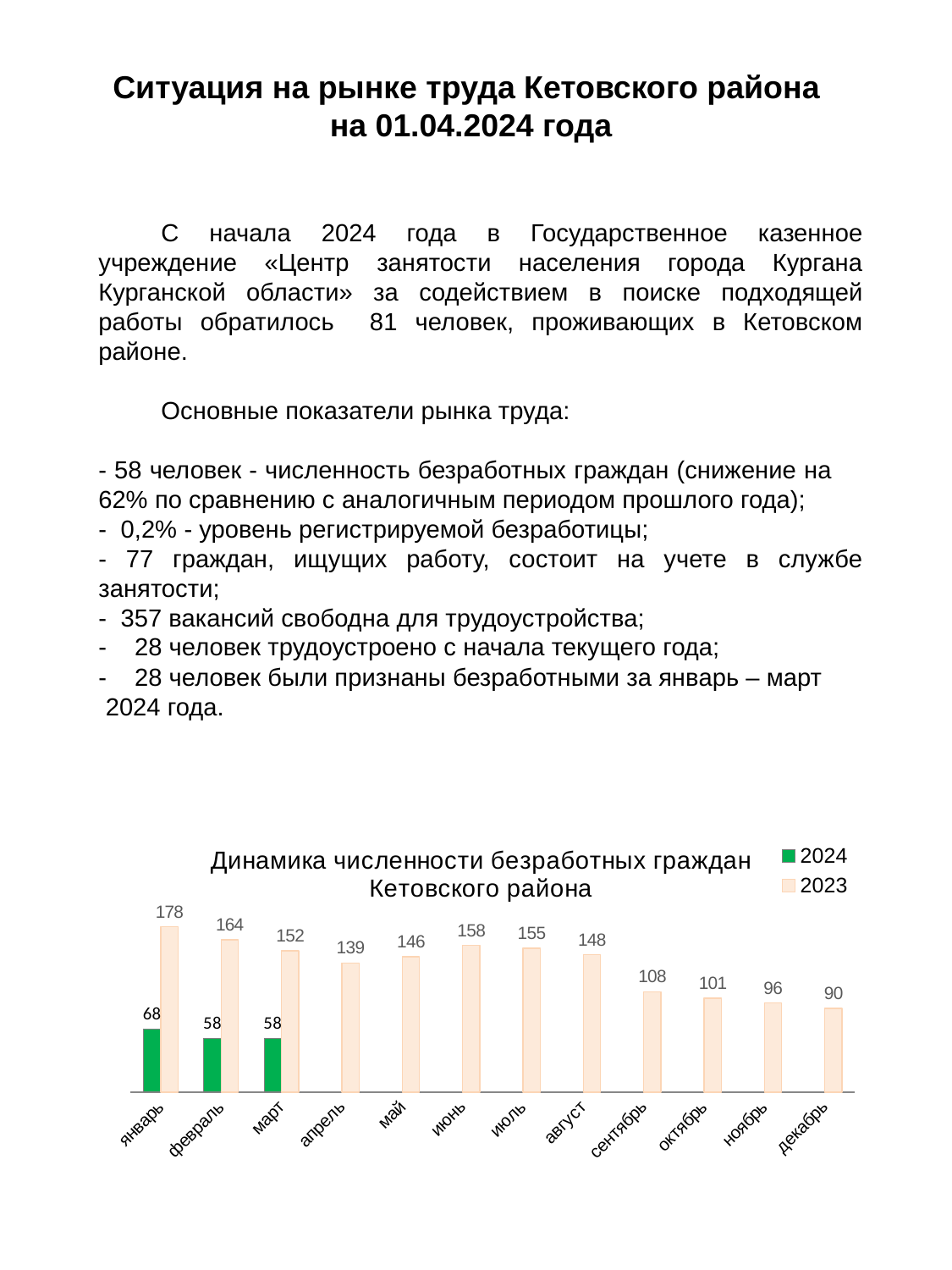
What is the value for 2023 in сентябрь? 108 Which month has the lowest value for the 2023 series? декабрь Which series is shown in green in the legend? 2024 What is the value for 2023 in январь? 178 Do the 2023 values rise or fall from сентябрь to декабрь? fall What is the difference between the 2023 and 2024 values in январь? 110 Which is larger: the 2023 value for июнь or the 2023 value for июль? июнь How many series does the legend list? 2 Which month has the highest value for the 2023 series? январь How many months are shown on the x axis? 12 What is the value for 2024 in март? 58 What kind of chart is shown on the slide? bar chart